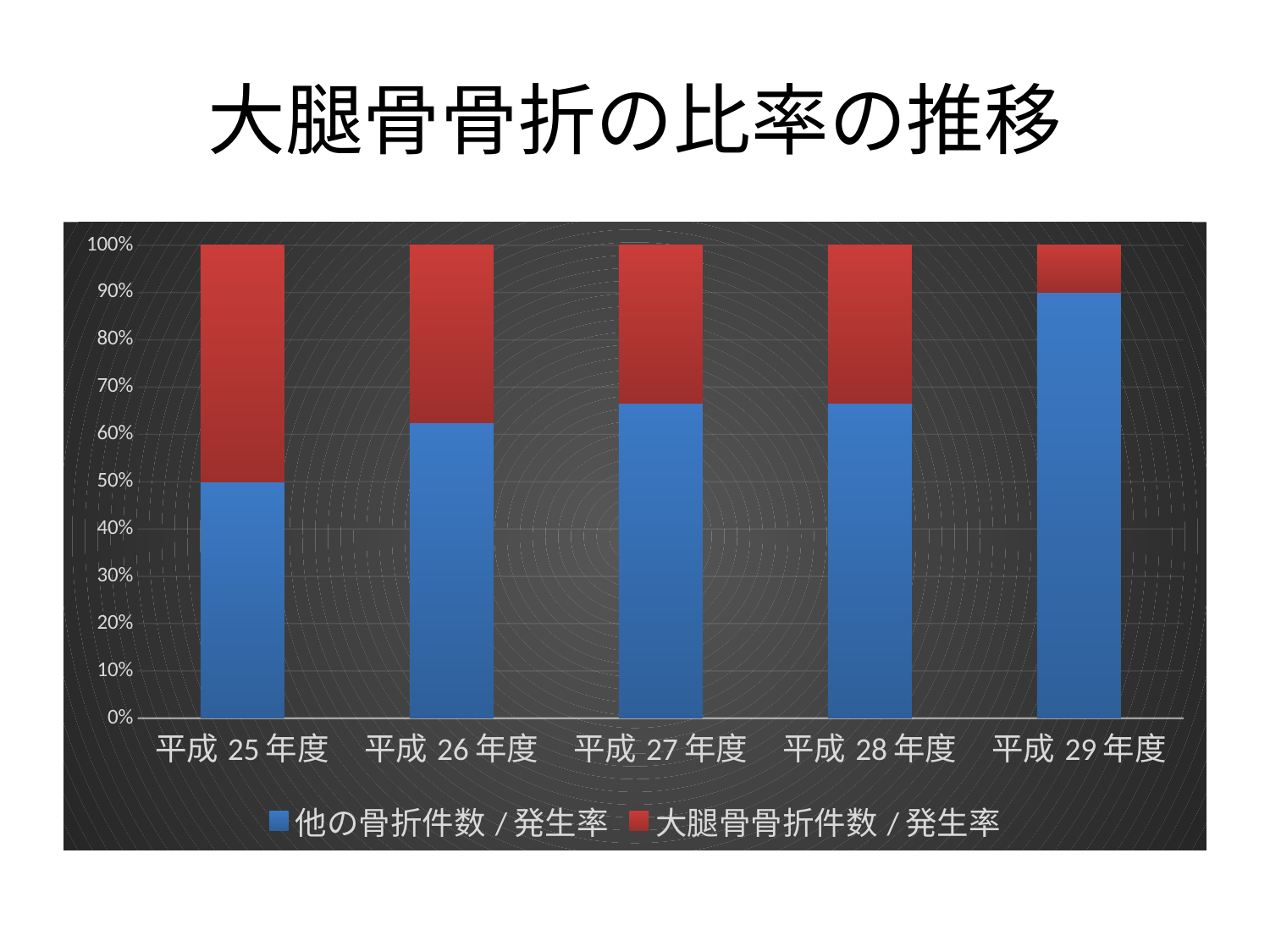
Does the share of 他の骨折件数 / 発生率 generally rise or fall from 平成 25 年度 to 平成 29 年度? rise What is the title of the slide? 大腿骨骨折の比率の推移 How many series does the legend list? 2 Is the value of 他の骨折件数 / 発生率 for 平成 26 年度 greater or less than 70%? less Which has the larger 大腿骨骨折件数 / 発生率 share, 平成 25 年度 or 平成 29 年度? 平成 25 年度 How many fiscal years (categories) are shown on the x axis? 5 What is the value of 他の骨折件数 / 発生率 for 平成 25 年度? 50% Is the value of 他の骨折件数 / 発生率 for 平成 27 年度 greater or less than 60%? greater Which fiscal year has the highest share of 他の骨折件数 / 発生率? 平成 29 年度 Is the 大腿骨骨折件数 / 発生率 share for 平成 29 年度 greater or less than 20%? less What kind of chart is shown on the slide? Stacked bar chart Which fiscal year has the lowest share of 他の骨折件数 / 発生率? 平成 25 年度